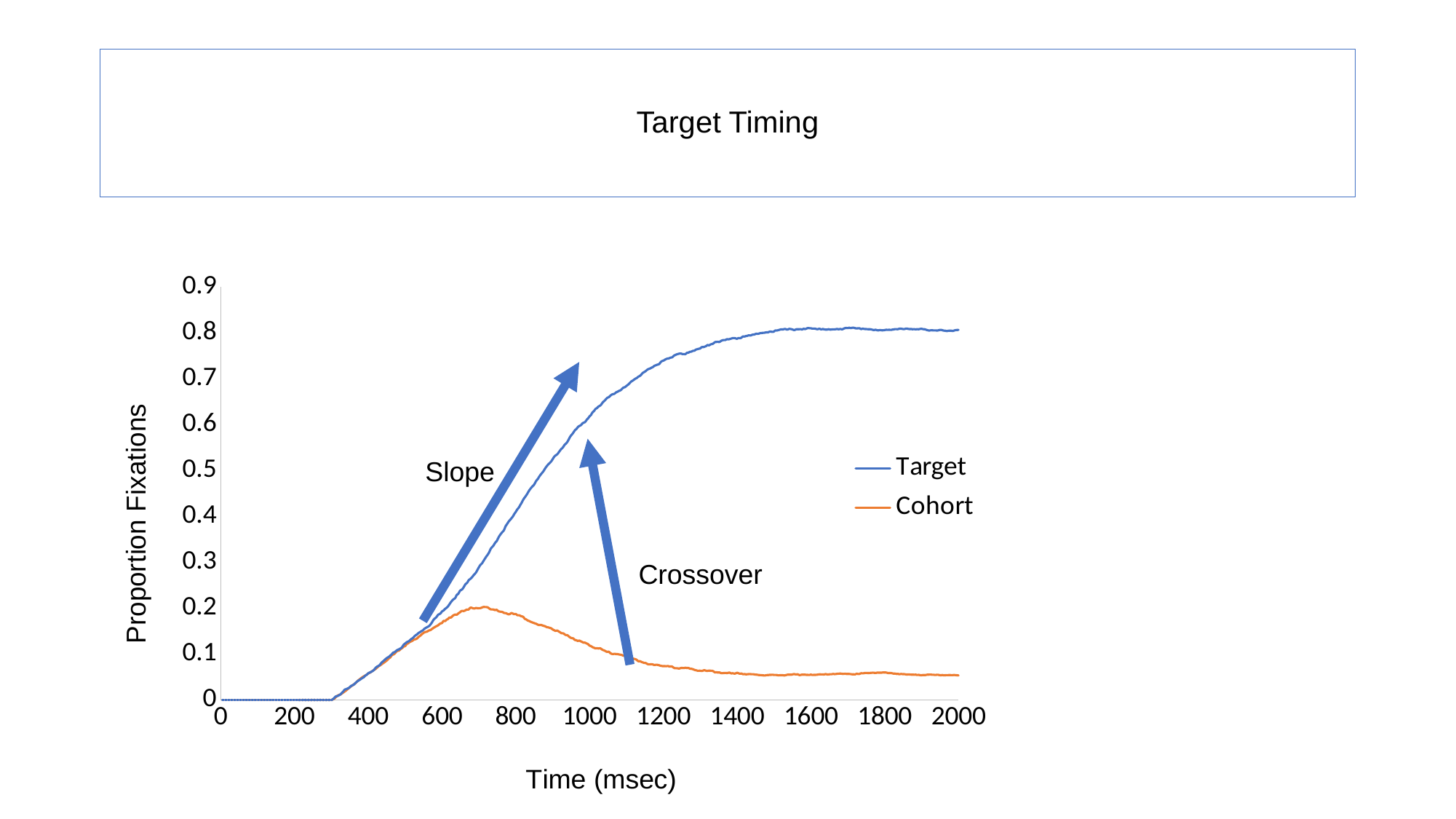
What are the two series named in the legend? Target and Cohort Does the Cohort line rise or fall between 800 and 1200 msec? fall How many series does the legend list? 2 What kind of chart is shown on the slide? line chart Is the value for Cohort at 2000 msec greater or less than 0.1? less Is the value for Target at 1000 msec greater or less than 0.5? greater At 1500 msec, which series has the larger value, Target or Cohort? Target Is the value for Target at 2000 msec greater or less than 0.7? greater What is the label of the x axis? Time (msec) Does the Target line rise or fall between 400 and 1400 msec? rise